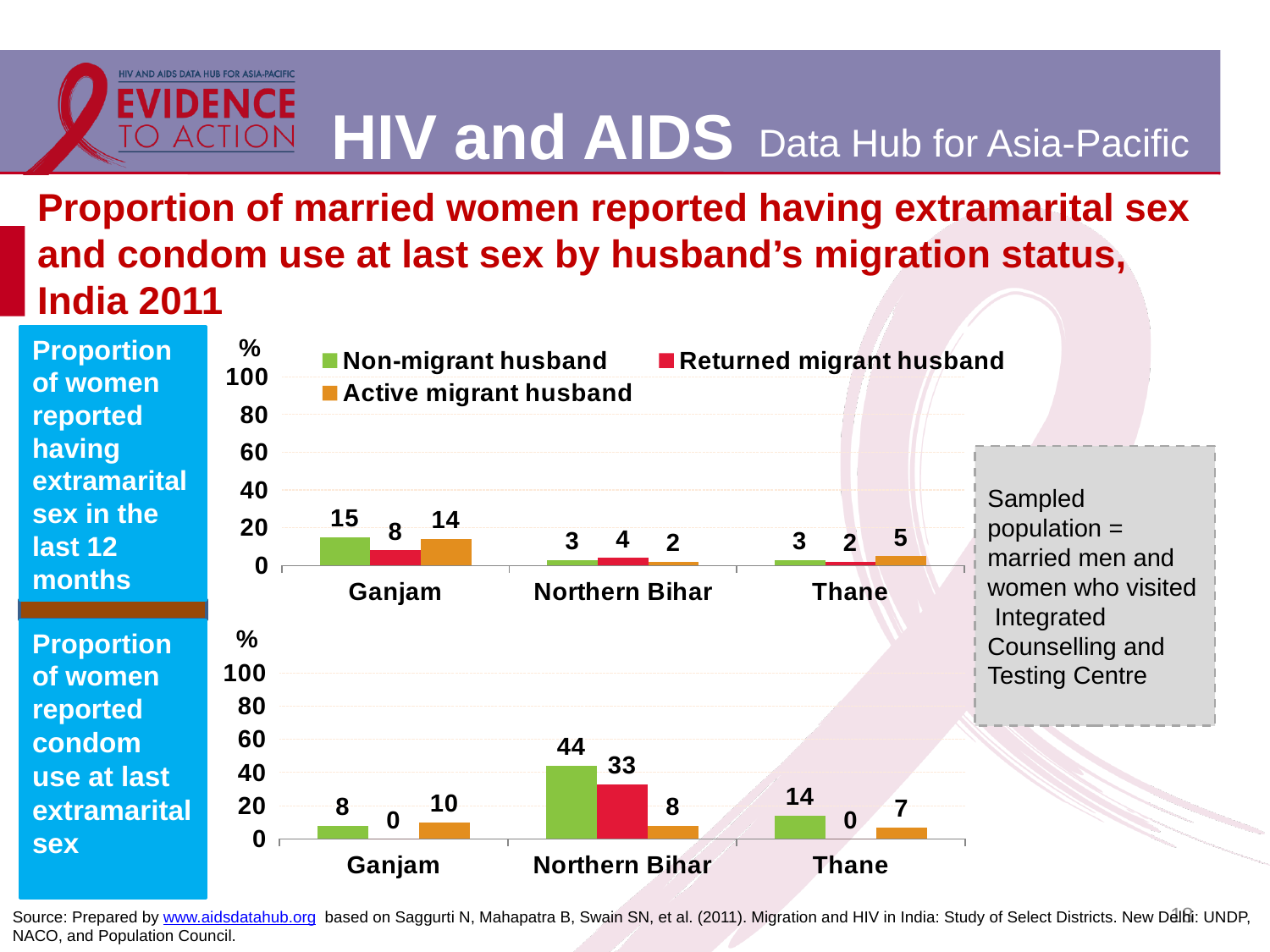
In the top chart (extramarital sex in the last 12 months), which is larger in Thane: the Active migrant husband value or the Non-migrant husband value? Active migrant husband In the top chart (extramarital sex in the last 12 months), what is the difference between the Non-migrant husband and Returned migrant husband values in Ganjam? 7 What type of chart is the bottom chart (condom use at last extramarital sex)? Bar chart In the top chart (extramarital sex in the last 12 months), which district has the highest value for Non-migrant husband? Ganjam In the bottom chart (condom use at last extramarital sex), is the value for Non-migrant husband in Northern Bihar greater or less than 40? greater In the top chart (proportion of women reported having extramarital sex in the last 12 months), what is the value for Non-migrant husband in Ganjam? 15 In the bottom chart (condom use at last extramarital sex), what is the value for Active migrant husband in Thane? 7 In the bottom chart (proportion of women reported condom use at last extramarital sex), what is the value for Returned migrant husband in Northern Bihar? 33 How many series does the legend list for the charts? 3 In the bottom chart (condom use at last extramarital sex), which district has the lowest value for Active migrant husband? Thane How many districts are shown on the x axis of the top chart? 3 In the bottom chart (condom use at last extramarital sex), what is the difference between the Non-migrant husband and Returned migrant husband values in Northern Bihar? 11